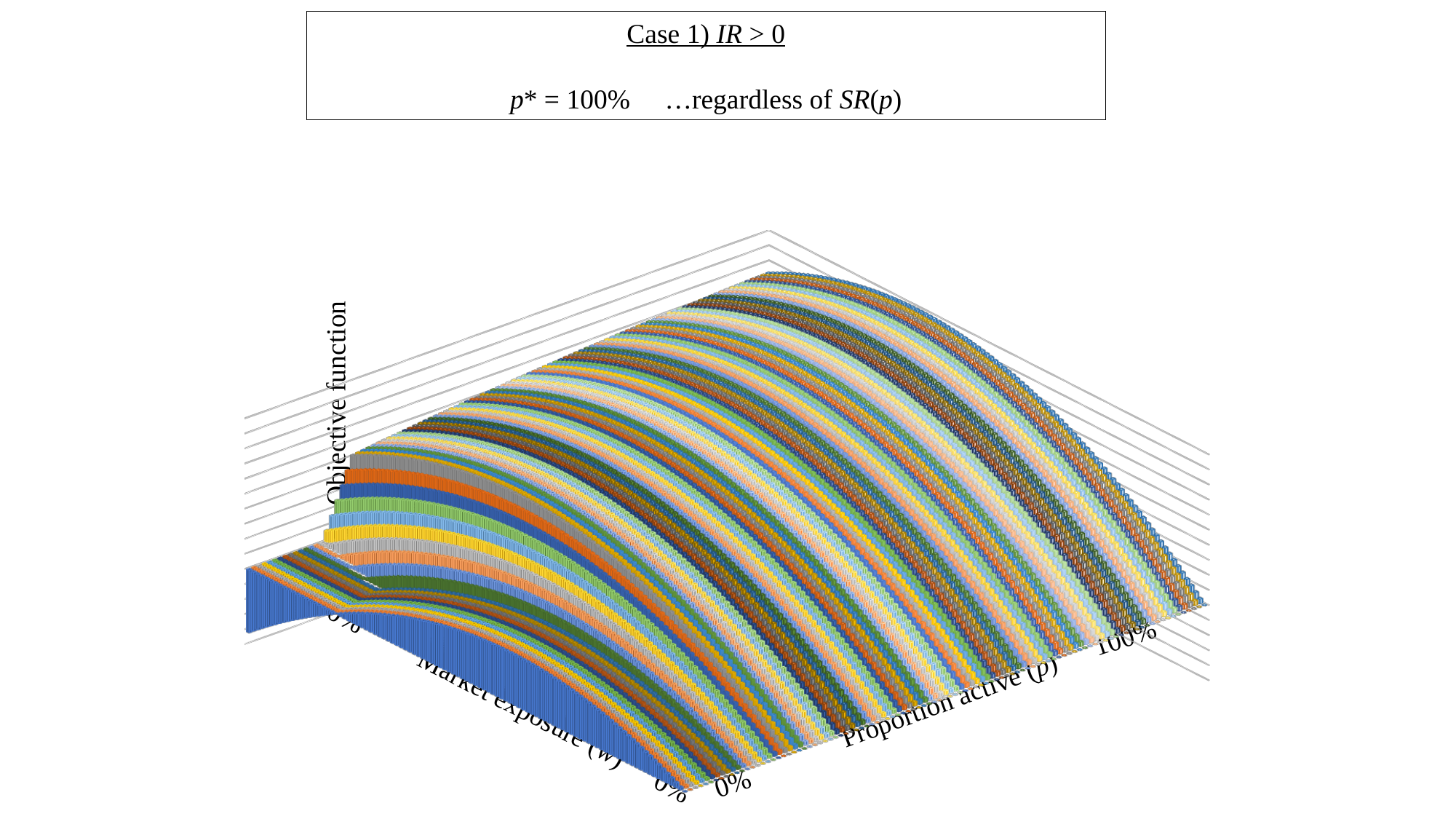
Moving along the Proportion active (p) axis from 0% to 100%, does the objective function surface generally rise or fall? rise What is the title of the vertical axis of the chart? Objective function How many tick labels are shown on the Proportion active (p) axis? 2 What are the titles of the two horizontal axes of the chart? Market exposure (w) and Proportion active (p) What kind of chart is shown on the slide? 3D bar chart